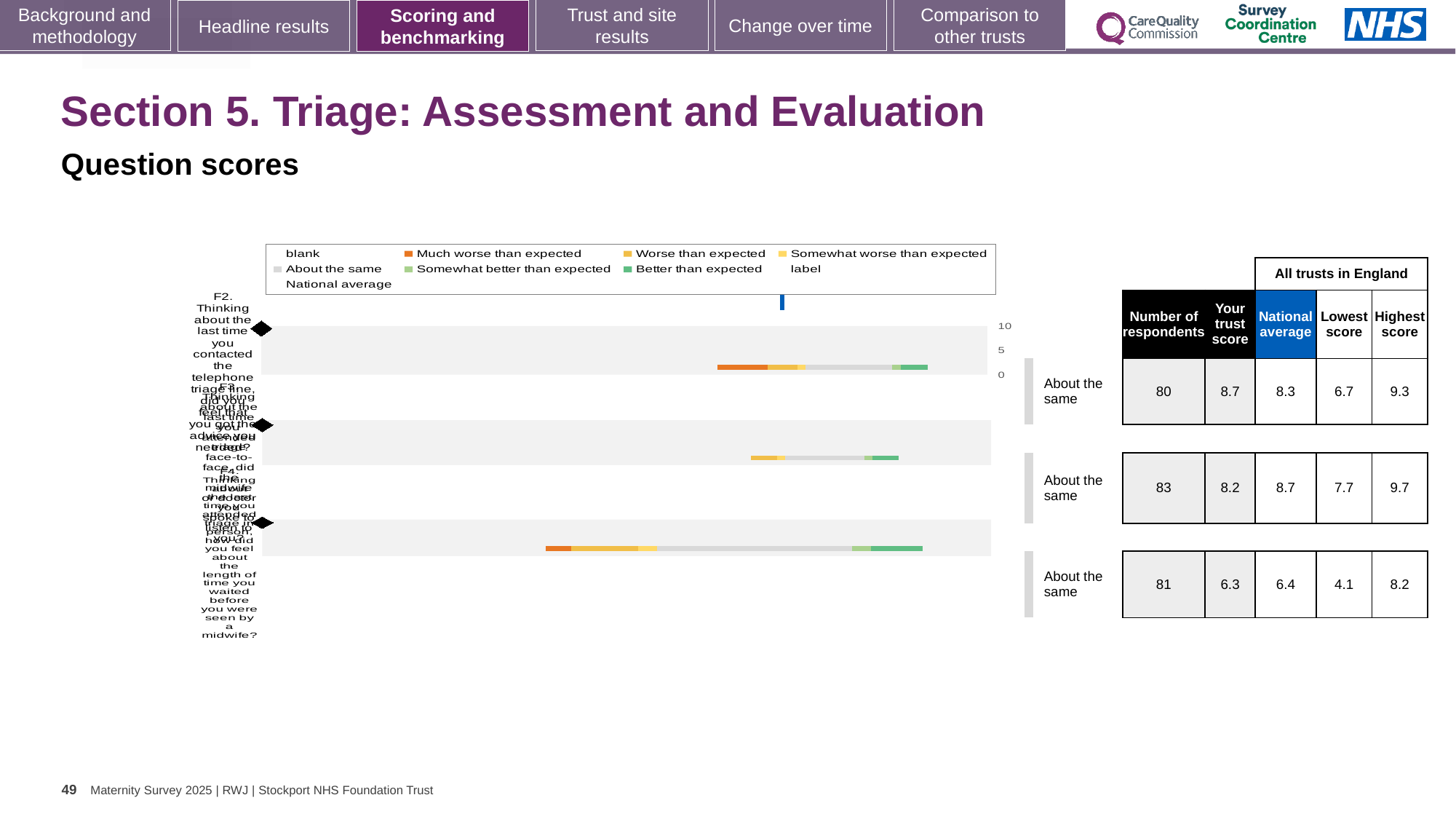
What kind of chart is shown on the slide? Bar chart Which question has the highest 'Your trust score'? The first (top) question F2, 8.7 How many questions (bars) are plotted in the chart? 3 What is the national average for the first (top) question, F2? 8.3 For the first question F2, which is larger: the trust score or the national average? The trust score (8.7) What is the 'Your trust score' for the first (top) question, F2? 8.7 What is the difference between the trust score and the national average for the first question F2? 0.4 What benchmark category is shown for all three questions? About the same What is the number of respondents for the second question? 83 What is the highest score among all trusts in England for the third (bottom) question? 8.2 What is the lowest score among all trusts in England for the third (bottom) question? 4.1 Which question has the lowest 'Your trust score'? The third (bottom) question, 6.3